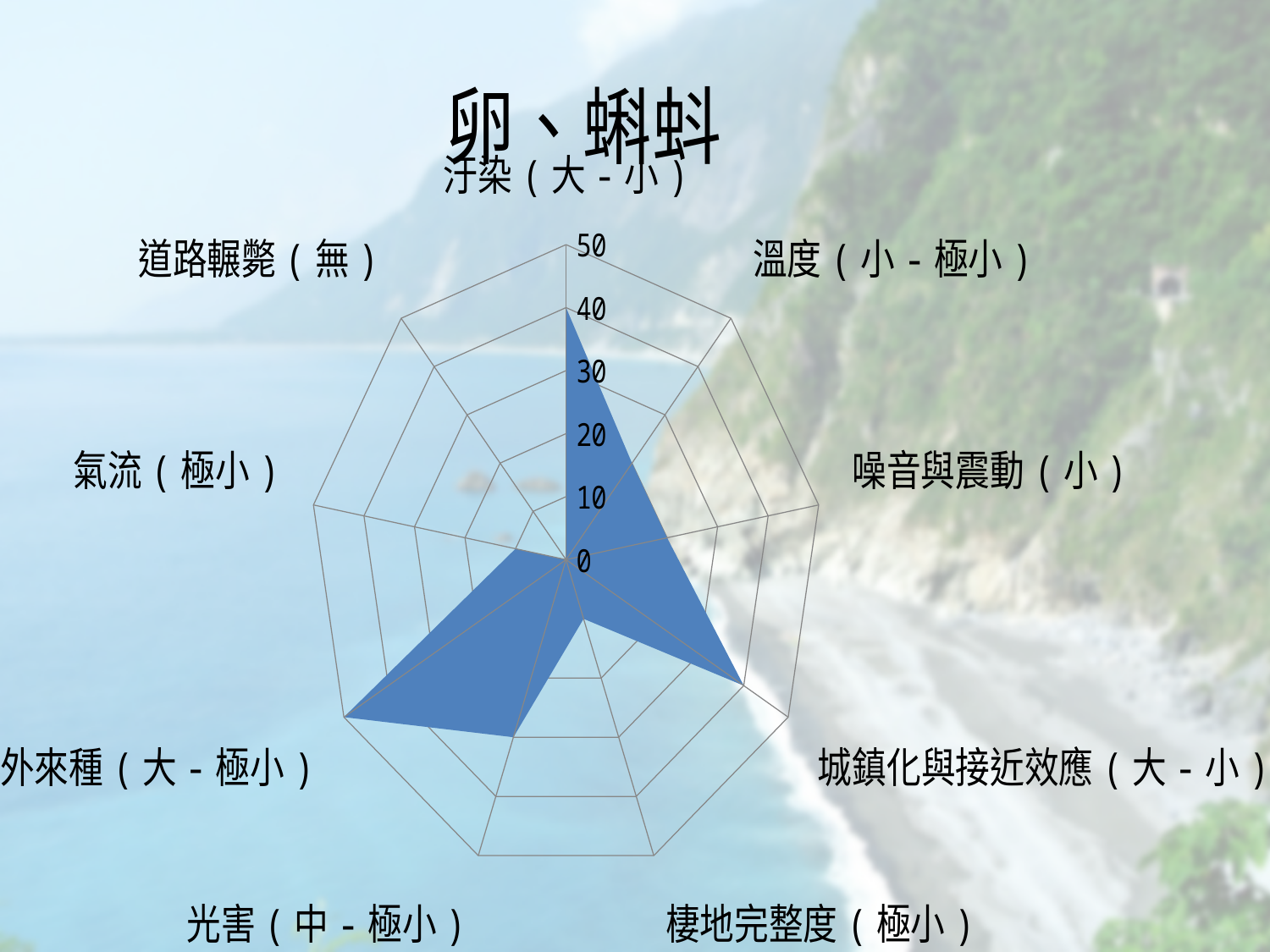
Is the value for 城鎮化與接近效應（大－小） greater or less than 30? greater What is the title of the chart? 卵、蝌蚪 What is the value for 道路輾斃（無）? 0 What kind of chart is shown on the slide? Radar chart How many categories (axes) does the radar chart have? 9 Is the value for 光害（中－極小） greater or less than 40? less What is the value for 汙染（大－小）? 40 Is the value for 外來種（大－極小） greater or less than 30? greater Which has a larger value, 城鎮化與接近效應（大－小） or 溫度（小－極小）? 城鎮化與接近效應（大－小） Which has a larger value, 汙染（大－小） or 光害（中－極小）? 汙染（大－小） What is the maximum value shown on the radar chart's axis scale? 50